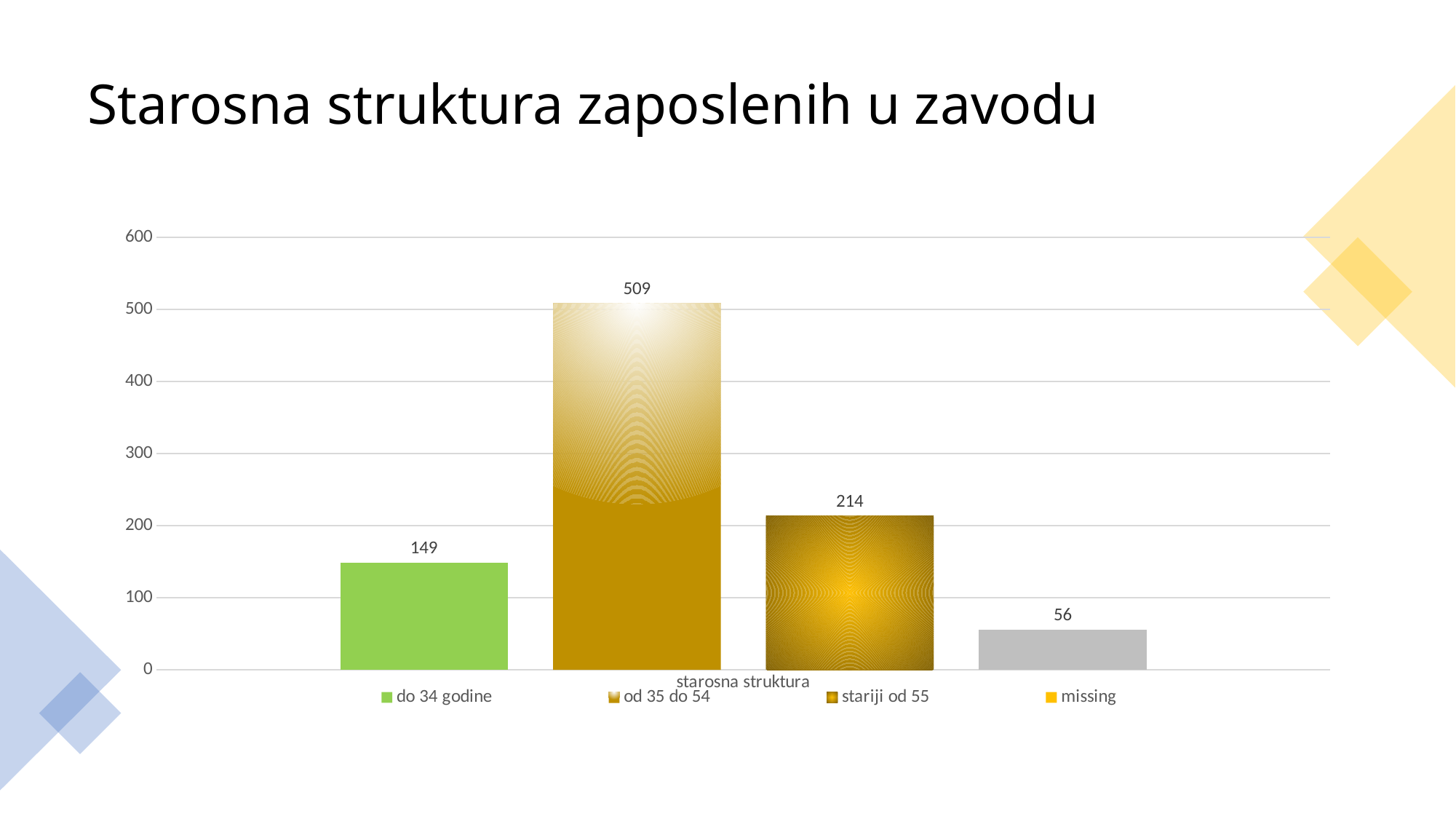
What is the value for 'stariji od 55'? 214 What kind of chart is shown on the slide? bar chart What is the value for 'do 34 godine'? 149 What is the value for 'od 35 do 54'? 509 What is the title of the slide? Starosna struktura zaposlenih u zavodu What is the value for 'missing'? 56 Which series has the highest value? od 35 do 54 How many series does the legend list? 4 Which is larger, the value for 'stariji od 55' or the value for 'do 34 godine'? stariji od 55 What is the difference between the values for 'od 35 do 54' and 'stariji od 55'? 295 Which series has the lowest value? missing Is the value for 'od 35 do 54' greater or less than 500? greater